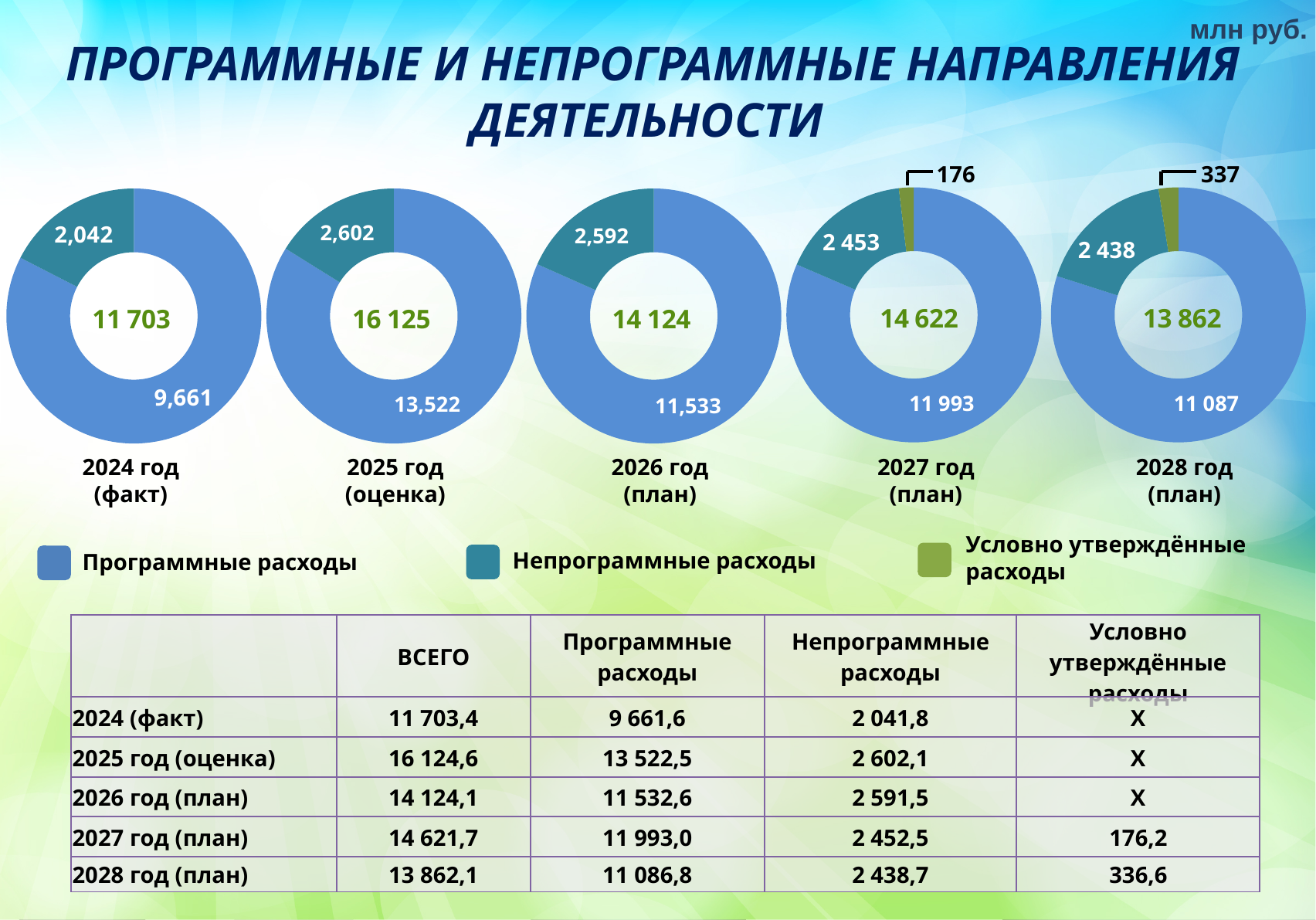
Which is larger: Программные расходы in the 2025 год (оценка) chart or Программные расходы in the 2026 год (план) chart? 2025 год (оценка) In the 2025 год (оценка) donut chart, what is the value for Непрограммные расходы? 2,602 How many donut charts are shown on the slide? 5 In the 2027 год (план) donut chart, what is the value for Условно утверждённые расходы? 176 In the 2026 год (план) donut chart, which segment is the largest? Программные расходы What total is shown in the centre of the 2028 год (план) donut chart? 13 862 In the 2028 год (план) donut chart, which segment is the smallest? Условно утверждённые расходы Which colour represents Непрограммные расходы in the legend? Teal In the 2027 год (план) donut chart, what is the difference between Программные расходы and Непрограммные расходы? 9 540 In the 2024 год (факт) donut chart, what is the value for Программные расходы? 9,661 How many series does the legend list? 3 What kind of chart is used to show the data for each year? Donut (pie) chart